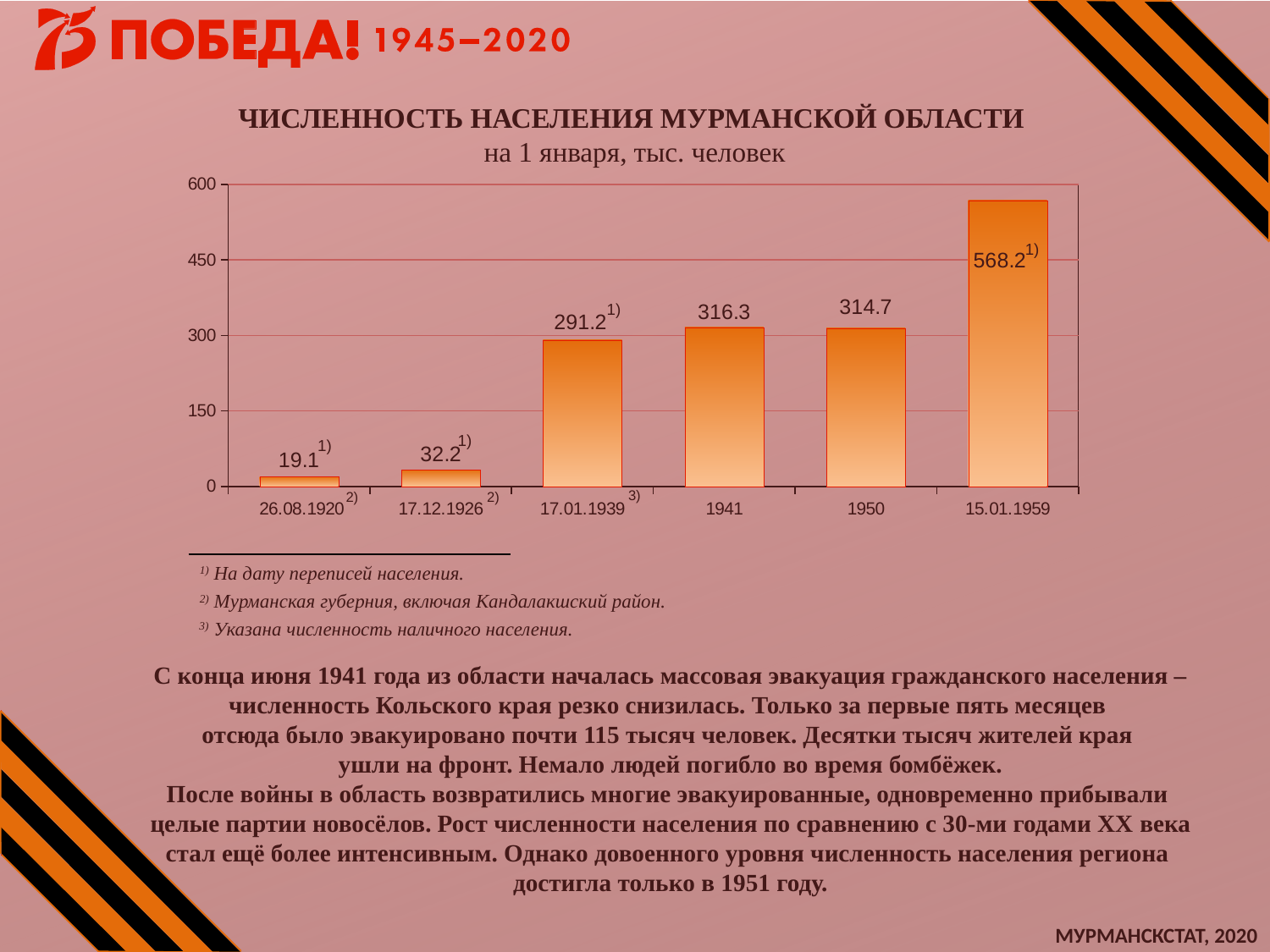
What kind of chart is shown on the slide? bar chart Which is larger, the value for 17.01.1939 or the value for 15.01.1959? 15.01.1959 What is the population value shown for 1941? 316.3 Which date has the lowest population value? 26.08.1920 What is the population value shown for 15.01.1959? 568.2 What is the difference between the values for 17.12.1926 and 26.08.1920? 13.1 What is the population value shown for 17.01.1939? 291.2 How many bars are shown in the chart? 6 Do the values rise or fall from 26.08.1920 to 17.01.1939? rise Is the value for 1950 greater or less than 450? less What is the difference between the values for 15.01.1959 and 1950? 253.5 Which date has the highest population value? 15.01.1959